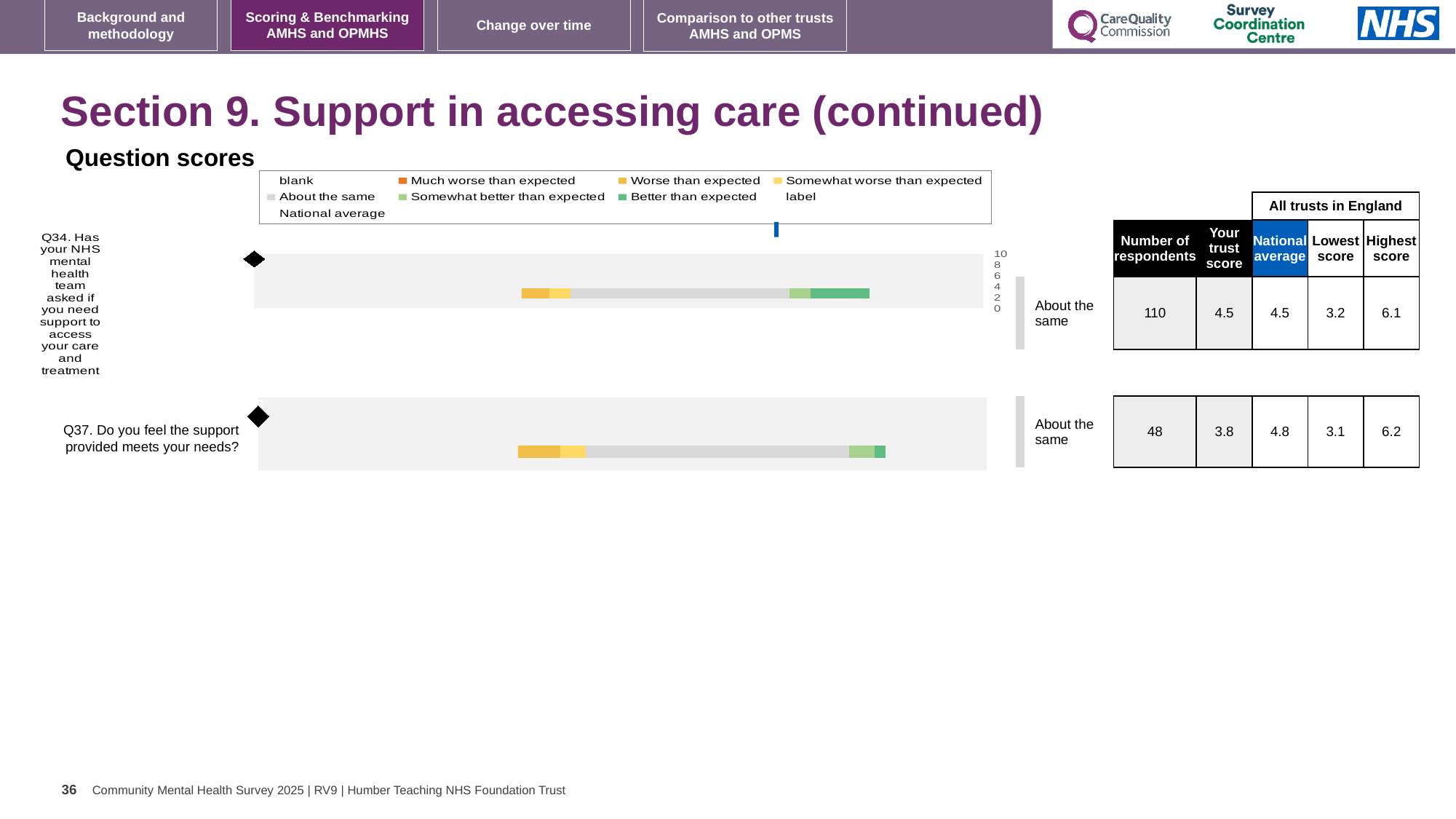
What is the difference between the national average and the trust score for Q37? 1.0 In the table beside the chart, what is the highest score for Q37? 6.2 What kind of chart is used to show the question scores on this slide? bar chart How many entries does the legend of the question scores chart list? 9 What benchmark category label is shown next to the bar for Q34? About the same In the table beside the chart, what is the trust score for Q37? 3.8 In the table beside the chart, what is the lowest score for Q34? 3.2 Which question has the higher trust score, Q34 or Q37? Q34 In the table beside the chart, what is the number of respondents for Q34? 110 Which question has more respondents, Q34 or Q37? Q34 In the table beside the chart, what is the national average for Q37? 4.8 How many questions are plotted in the question scores chart? 2